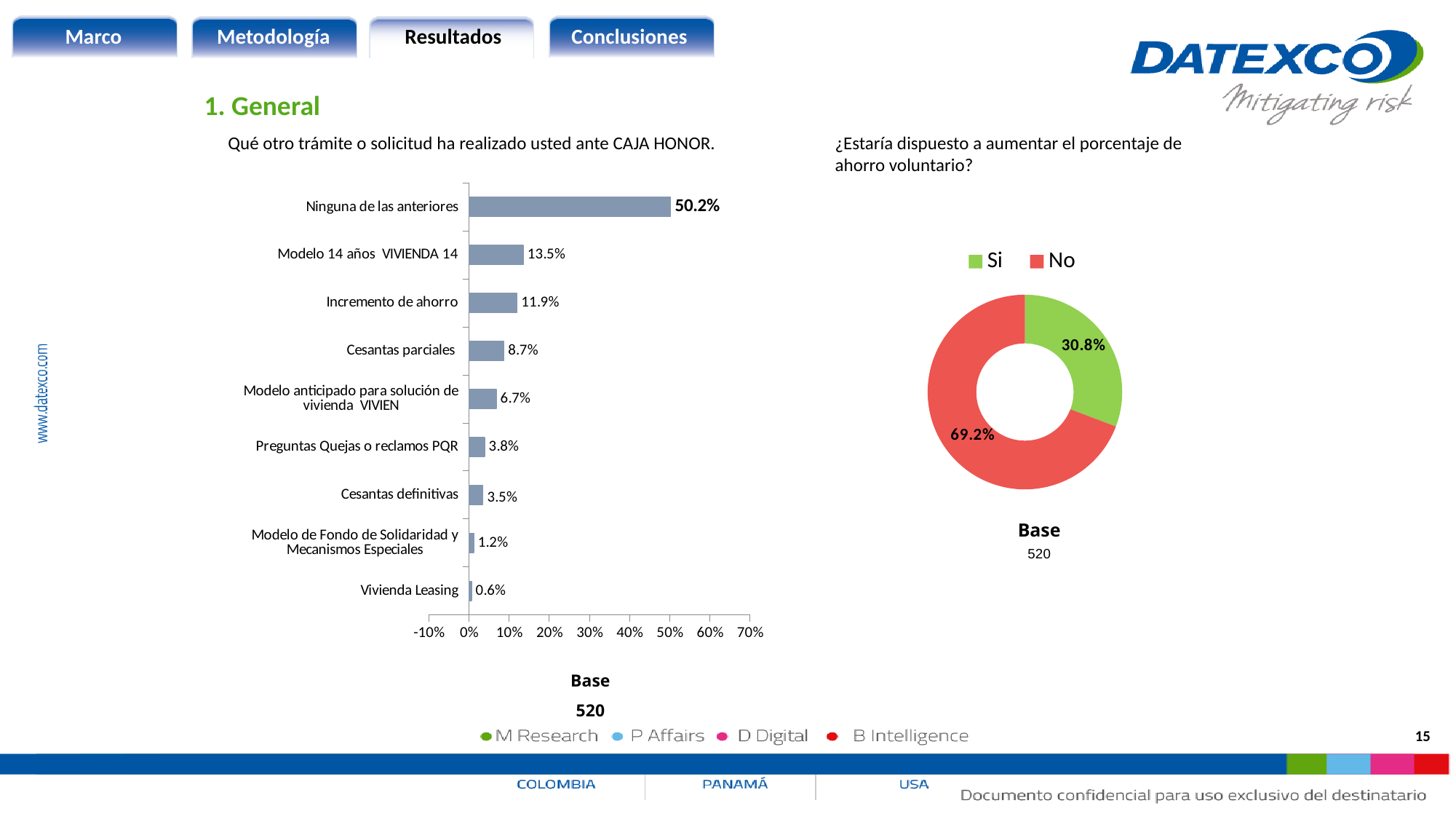
In the bar chart on the left, what is the value for "Incremento de ahorro"? 11.9% In the doughnut chart on the right, what share of respondents answered "Si"? 30.8% What kind of chart is the chart on the left? Bar chart In the doughnut chart on the right, what is the value for "No"? 69.2% How many categories are shown in the bar chart on the left? 9 In the bar chart on the left, what is the difference between "Modelo 14 años VIVIENDA 14" and "Cesantas parciales"? 4.8% How many entries does the legend of the doughnut chart on the right list? 2 In the doughnut chart on the right, what colour represents "No"? Red In the bar chart on the left, which category has the lowest value? Vivienda Leasing In the bar chart on the left, which category has the highest value? Ninguna de las anteriores In the bar chart on the left, what is the value for "Ninguna de las anteriores"? 50.2% In the bar chart on the left, which is larger: "Preguntas Quejas o reclamos PQR" or "Cesantas definitivas"? Preguntas Quejas o reclamos PQR